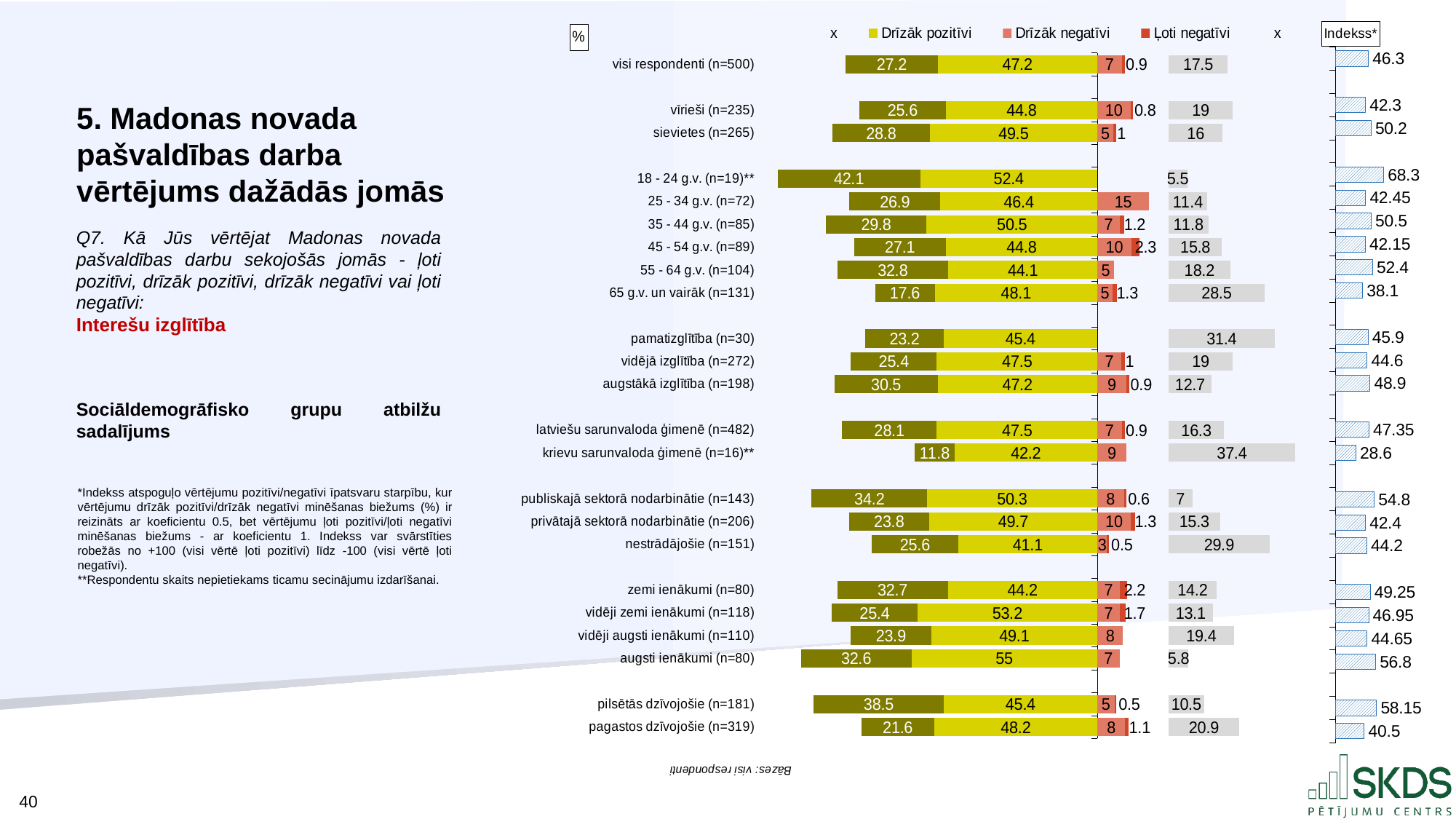
What is the 'Drīzāk negatīvi' value for '25 - 34 g.v. (n=72)'? 15 What is the Indekss* value for '18 - 24 g.v. (n=19)**'? 68.3 What is the 'Drīzāk pozitīvi' value for 'visi respondenti (n=500)'? 47.2 What is the value of the grey segment for 'krievu sarunvaloda ģimenē (n=16)**'? 37.4 Which group has a larger 'Drīzāk pozitīvi' value: 'augsti ienākumi (n=80)' or 'vidēji zemi ienākumi (n=118)'? augsti ienākumi (n=80) How many respondent groups (categories) are shown in the chart? 23 What is the difference between the Indekss* values for 'pilsētās dzīvojošie (n=181)' and 'pagastos dzīvojošie (n=319)'? 17.65 Which area of municipal work (shown in red under the question text) does this chart evaluate? Interešu izglītība Which respondent group has the lowest Indekss* value? krievu sarunvaloda ģimenē (n=16)** What is the difference between the Indekss* values for 'sievietes (n=265)' and 'vīrieši (n=235)'? 7.9 Which respondent group has the highest Indekss* value? 18 - 24 g.v. (n=19)** What kind of chart is used to show the respondent groups' answers? Stacked bar chart